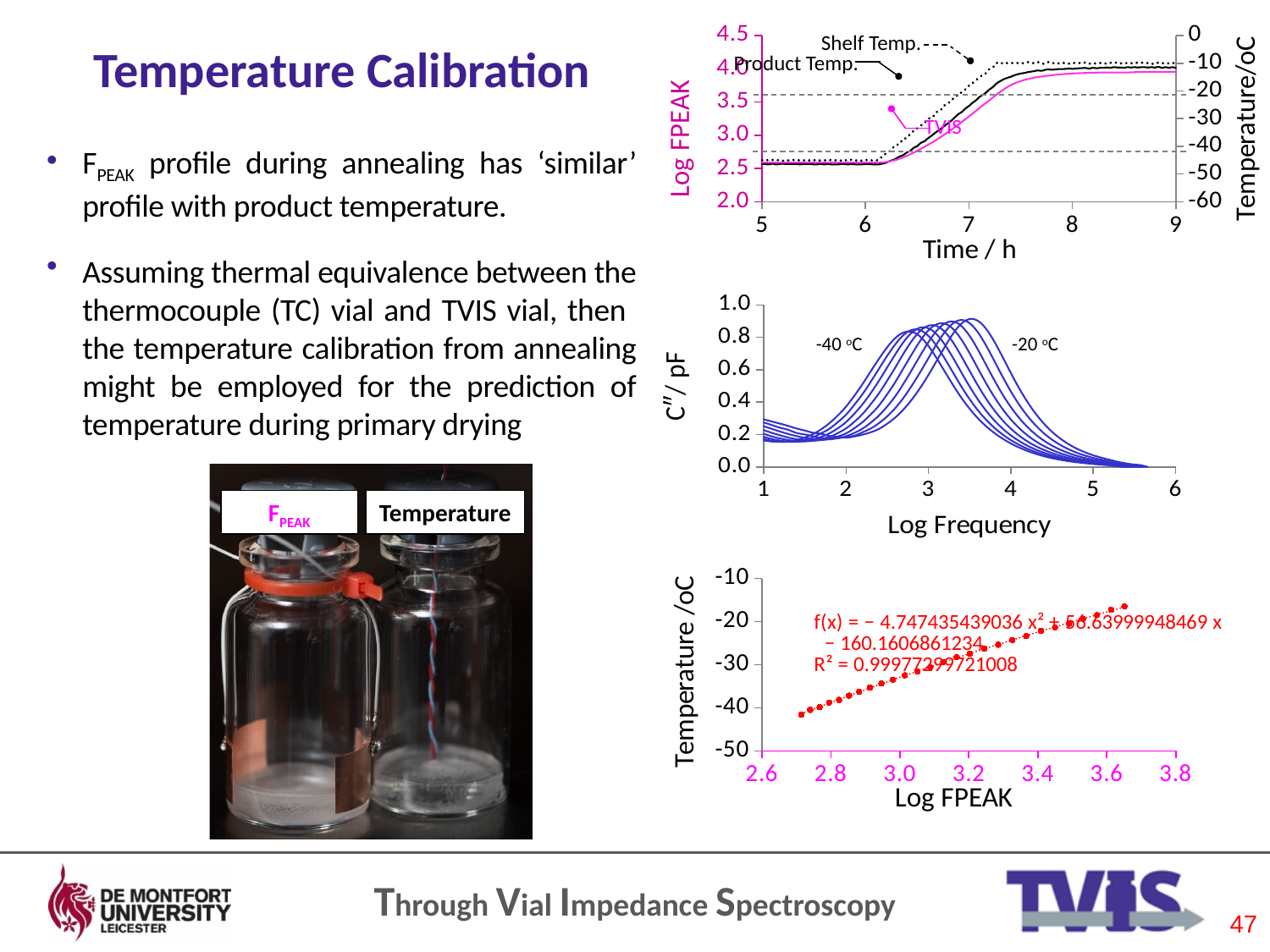
In the middle chart (C''/ pF vs Log Frequency), is the highest peak value of C'' greater or less than 1.0 pF? less In the bottom chart (Temperature /oC vs Log FPEAK), what R² value is printed for the fitted curve? 0.99977299721008 In the bottom chart (Temperature /oC vs Log FPEAK), does temperature rise or fall as Log FPEAK increases? rise In the top chart (Log FPEAK vs Time / h), what is the label of the right-hand y axis? Temperature/oC In the top chart (Log FPEAK vs Time / h), is the Shelf Temp. value at 9 h greater or less than -20 on the temperature axis? greater In the top chart (Log FPEAK vs Time / h), what is the label of the x axis? Time / h In the top chart (Log FPEAK vs Time / h), is the TVIS Log FPEAK value at 9 h greater or less than 3.5? greater What kind of chart is the bottom chart (Temperature /oC vs Log FPEAK)? scatter chart In the middle chart (C''/ pF vs Log Frequency), which two temperatures are annotated on the curves? -40 °C and -20 °C What kind of chart is the middle chart (C''/ pF vs Log Frequency)? line chart In the top chart (Log FPEAK vs Time / h), does the TVIS Log FPEAK value rise or fall as time increases from 6 h to 8 h? rise